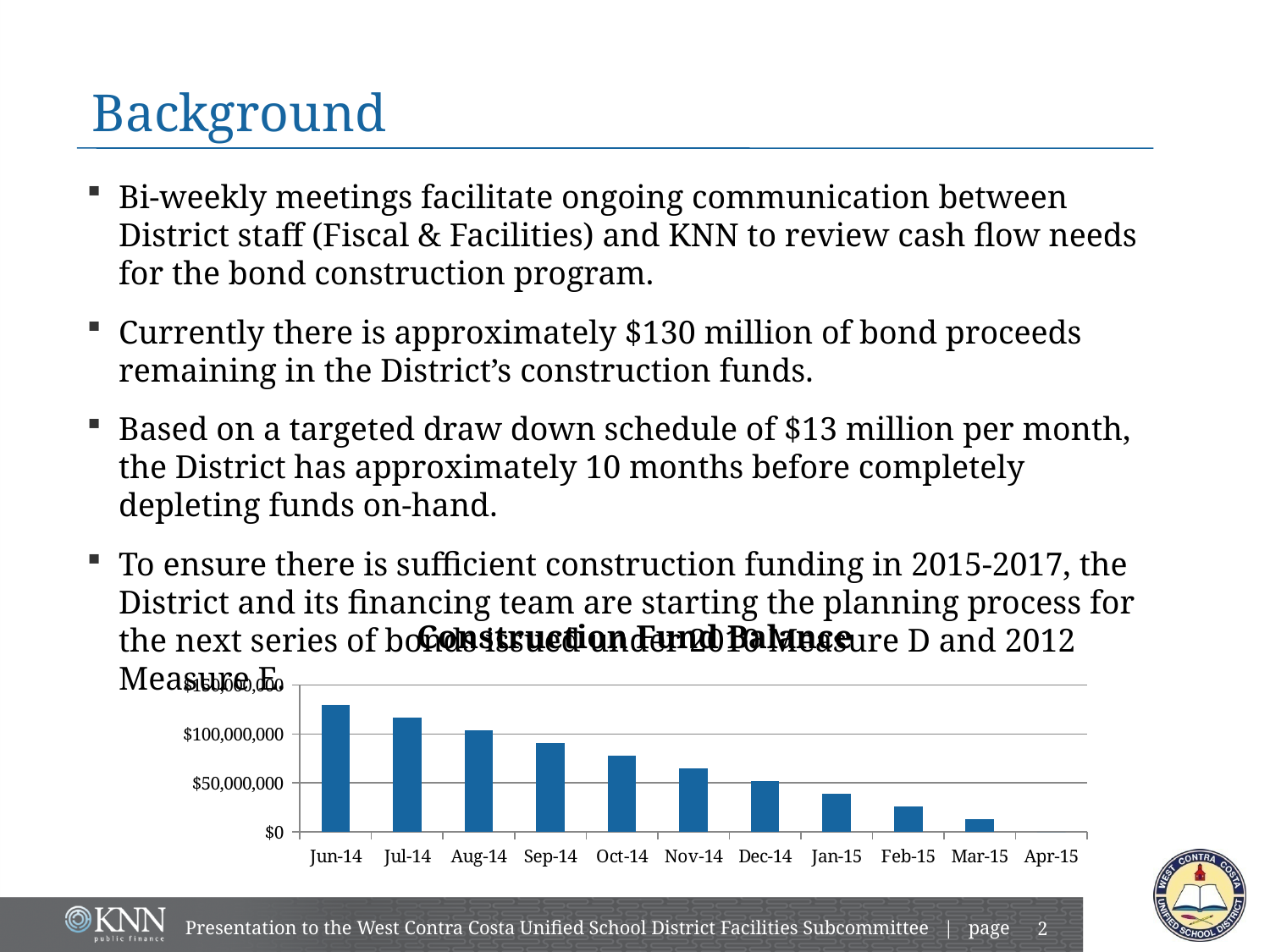
Which month has the tallest bar in the chart? Jun-14 Do the bar values rise or fall from Jun-14 to Mar-15? fall What is the title of the chart? Construction Fund Balance Is the value for Sep-14 greater or less than $100,000,000? less Which is larger, the value for Jul-14 or the value for Oct-14? Jul-14 Is the value for Jan-15 greater or less than $50,000,000? less How many months are labeled along the x axis of the chart? 11 What type of chart is shown on the slide? bar chart Is the value for Jun-14 greater or less than $100,000,000? greater What is the highest value labeled on the y axis of the chart? $150,000,000 Which month has the shortest visible bar in the chart? Mar-15